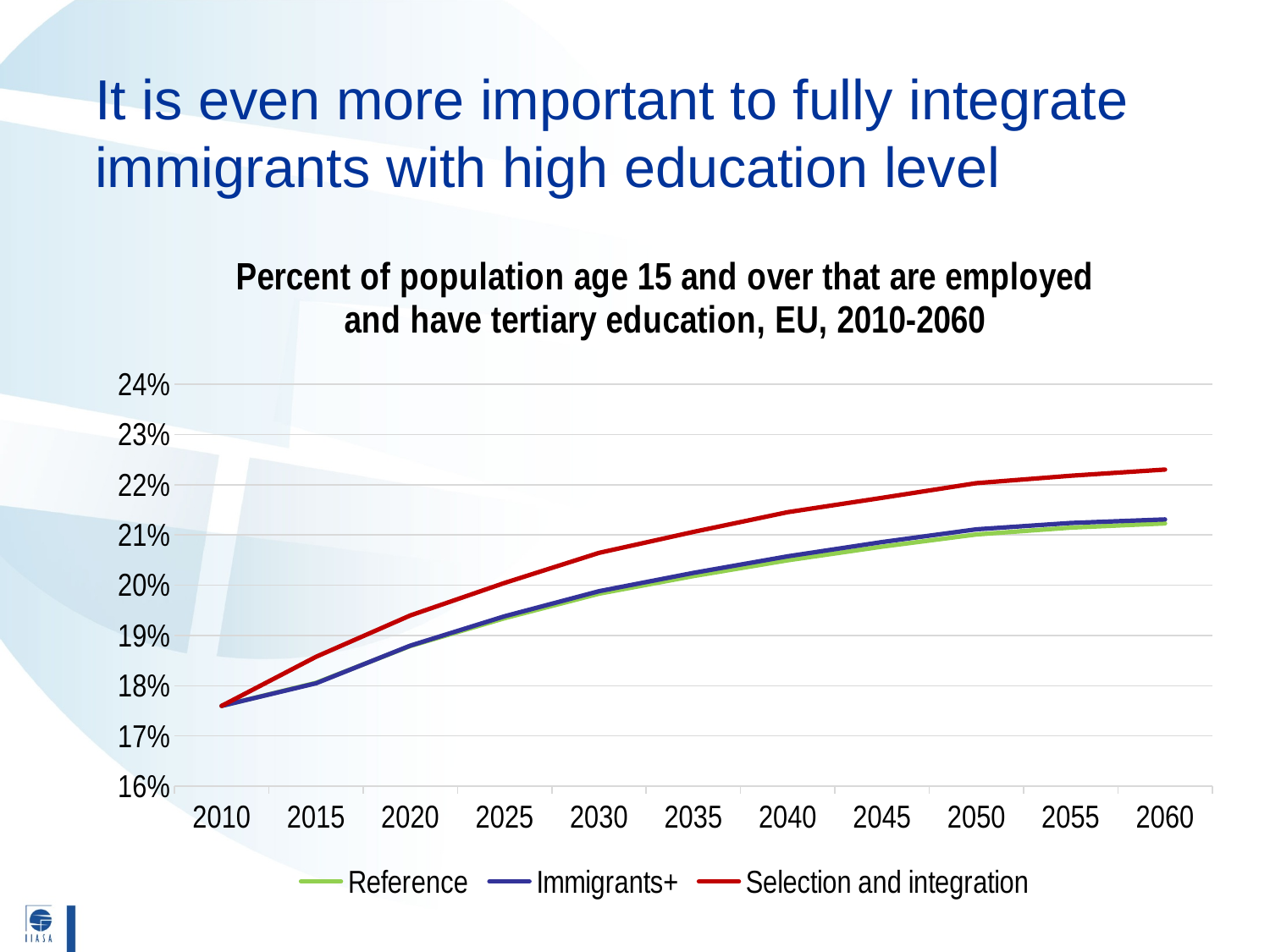
Is the value for Selection and integration in 2060 greater or less than 22%? greater How many years are labelled along the x axis? 11 Is the value for Reference in 2010 greater or less than 18%? less In 2060, which is larger: the value for Selection and integration or the value for Reference? Selection and integration Do the values for the Reference series rise or fall from 2010 to 2060? rise Which series has the highest value in 2060? Selection and integration Is the value for Immigrants+ in 2060 greater or less than 21%? greater How many series does the legend list? 3 What kind of chart is shown on the slide? line chart What colour is the line for the Selection and integration series? red Do the values for the Selection and integration series rise or fall from 2010 to 2060? rise